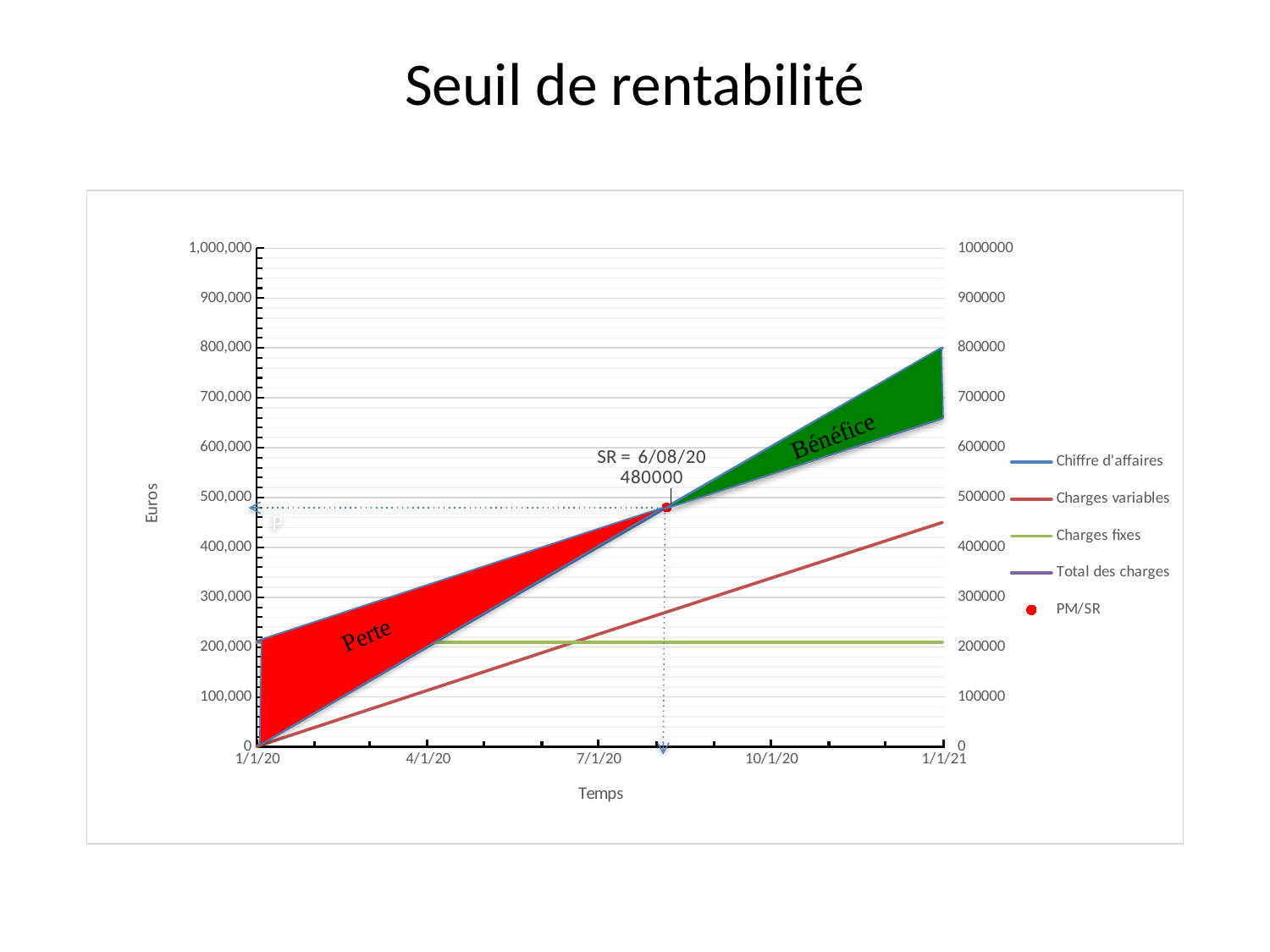
Does the Chiffre d'affaires line rise or fall from 1/1/20 to 1/1/21? rise How many dates are labelled on the x axis? 5 On what date does the chart place the break-even point (SR)? 6/08/20 What is the title of the slide? Seuil de rentabilité Is the value of Charges variables at 1/1/21 greater or less than 500,000? less At 1/1/21, which is larger: Chiffre d'affaires or Charges variables? Chiffre d'affaires Is the value of Charges fixes greater or less than 300,000? less What kind of chart is shown on the slide? line chart What label is shown on the vertical axis of the chart? Euros What value in euros is printed at the break-even point (SR) on the chart? 480000 Is the value of Chiffre d'affaires at 1/1/21 greater or less than 700,000? greater How many series does the legend list? 5